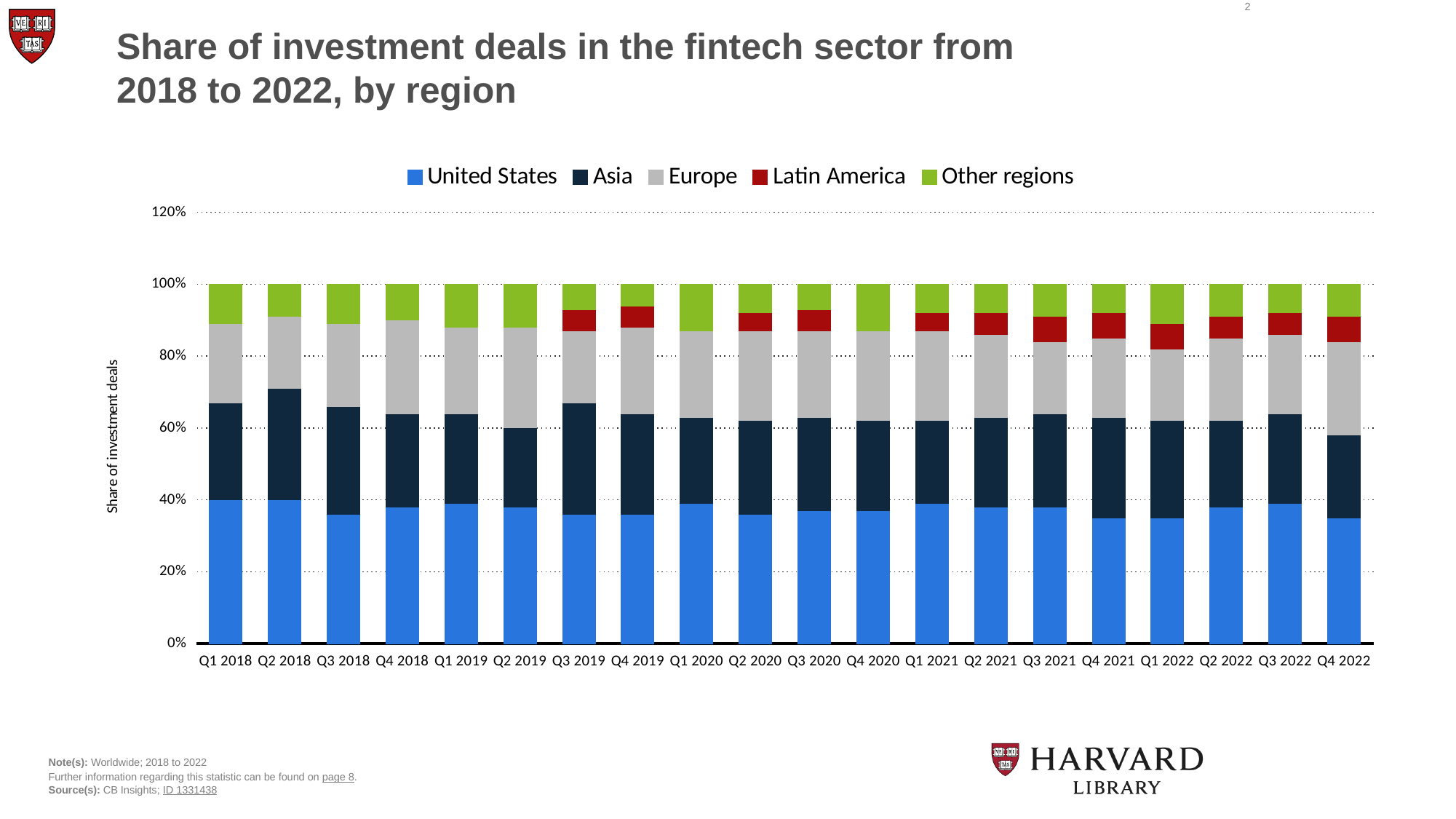
How many series does the legend list? 5 Which series is plotted at the bottom of each stacked bar? United States Is the combined share of the United States and Asia in Q2 2018 greater or less than 60%? greater Which regions are listed in the legend? United States, Asia, Europe, Latin America, Other regions Which is larger, the United States share in Q2 2018 or in Q4 2022? Q2 2018 What is the total height of each stacked bar? 100% Is the United States share in Q4 2022 greater or less than 40%? less How many quarters are shown along the x axis? 20 Is the United States share in Q3 2018 greater or less than 40%? less What kind of chart is shown on the slide? bar chart Does the United States share rise or fall from Q1 2018 to Q4 2022? fall